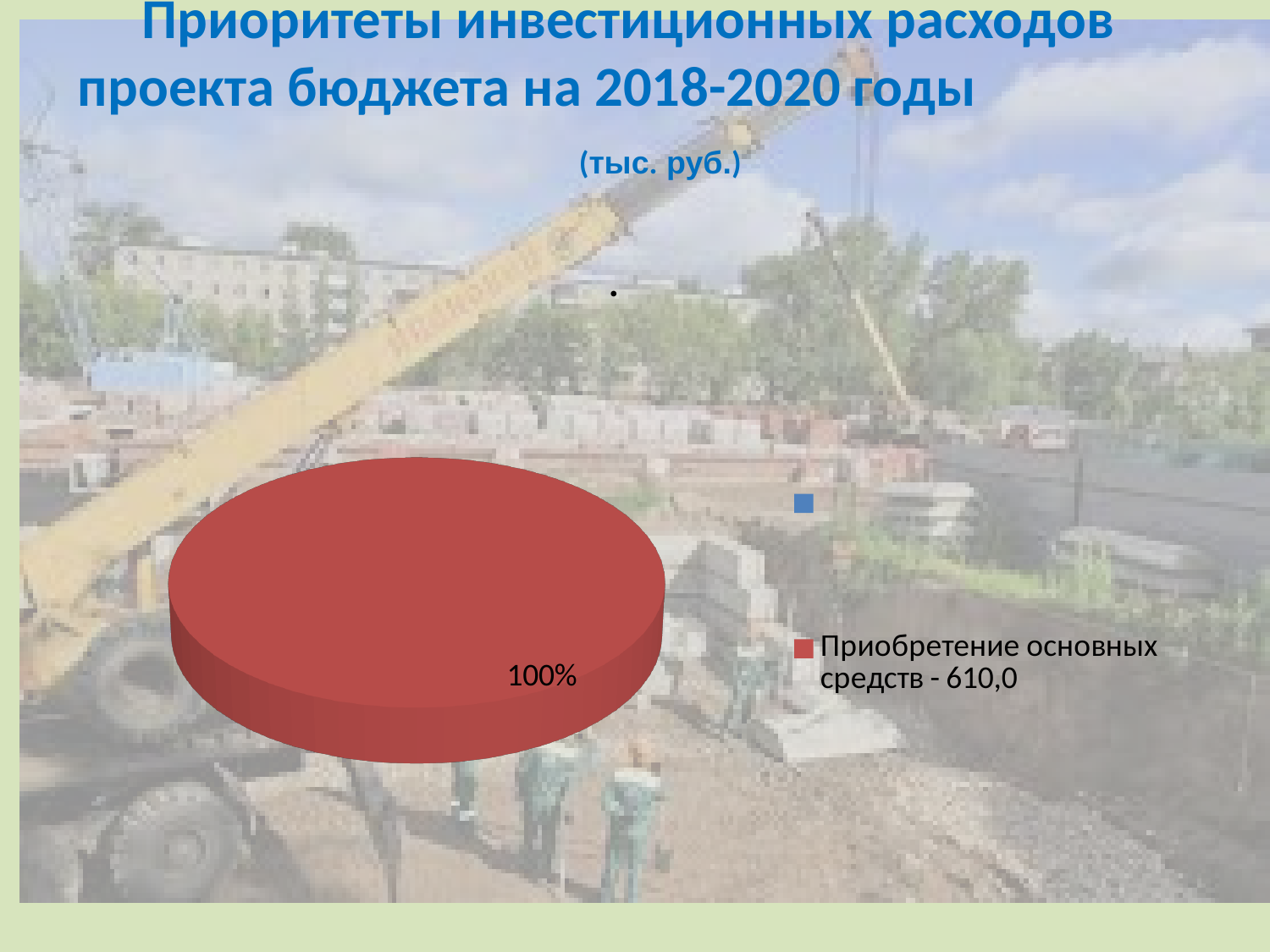
What value is given in the legend for "Приобретение основных средств"? 610,0 How many slices are visible in the pie chart? 1 What unit is stated under the chart title? тыс. руб. What kind of chart is shown on the slide? pie chart What percentage label is printed on the pie slice? 100% What share of the pie does the slice "Приобретение основных средств" represent? 100% What colour is the slice labelled 100%? red